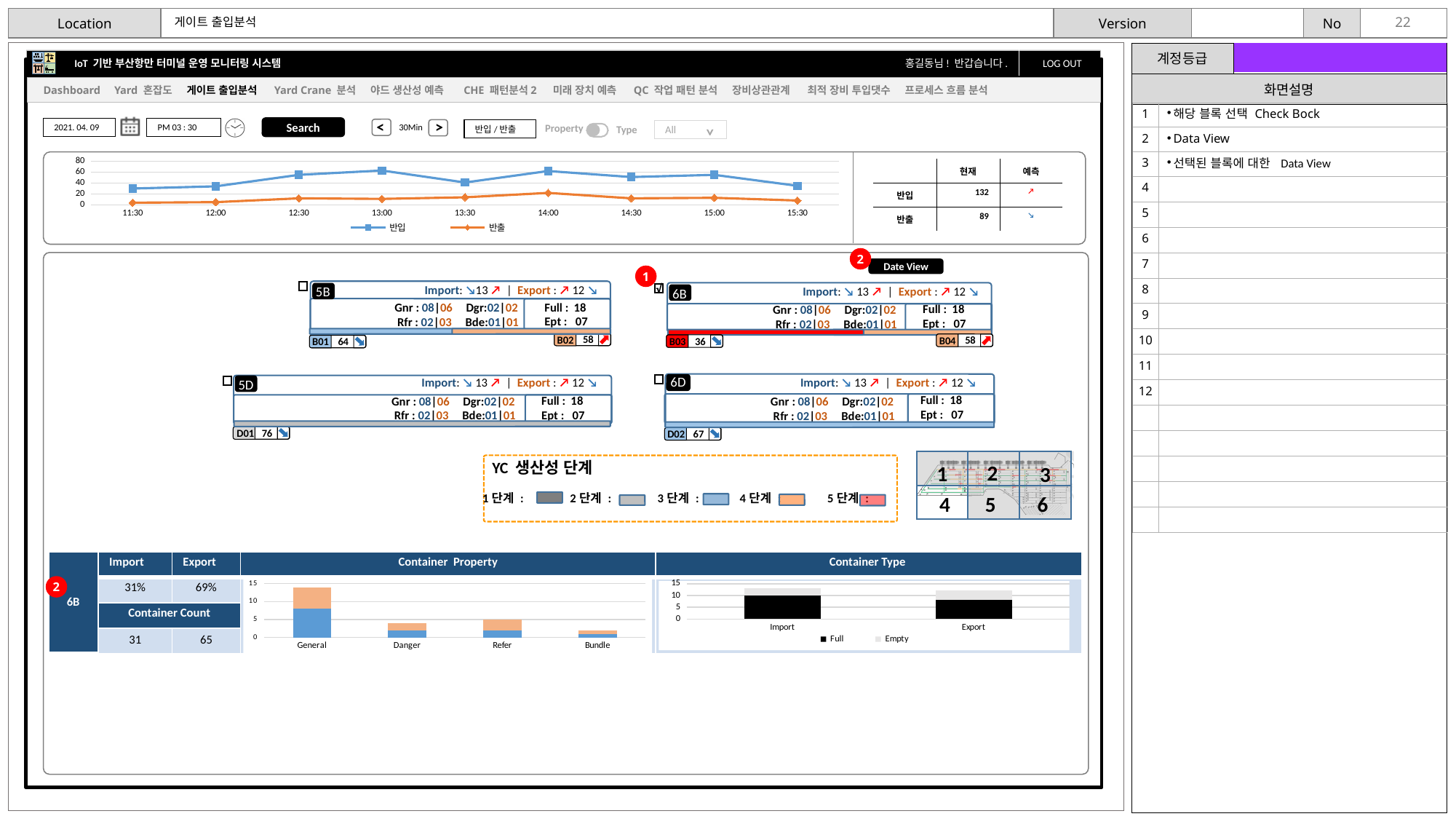
In the Container Property chart, which category has the shortest bar? Bundle In the Container Type chart, what are the two legend entries? Full, Empty In the Container Property chart, which category has the tallest bar? General What kind of chart is the chart at the top of the dashboard with the 11:30 to 15:30 time axis? line chart How many time points are shown on the x axis of the top line chart? 9 In the top line chart, is the value for 반출 at 11:30 greater or less than 20? less In the top line chart, does the 반입 series rise or fall from 11:30 to 13:00? rise In the top line chart, which series is higher at 14:00, 반입 or 반출? 반입 How many series does the legend of the top line chart list? 2 In the top line chart, is the value for 반입 at 13:00 greater or less than 40? greater How many categories are shown on the x axis of the Container Property chart? 4 What kind of chart is the Container Property chart? bar chart